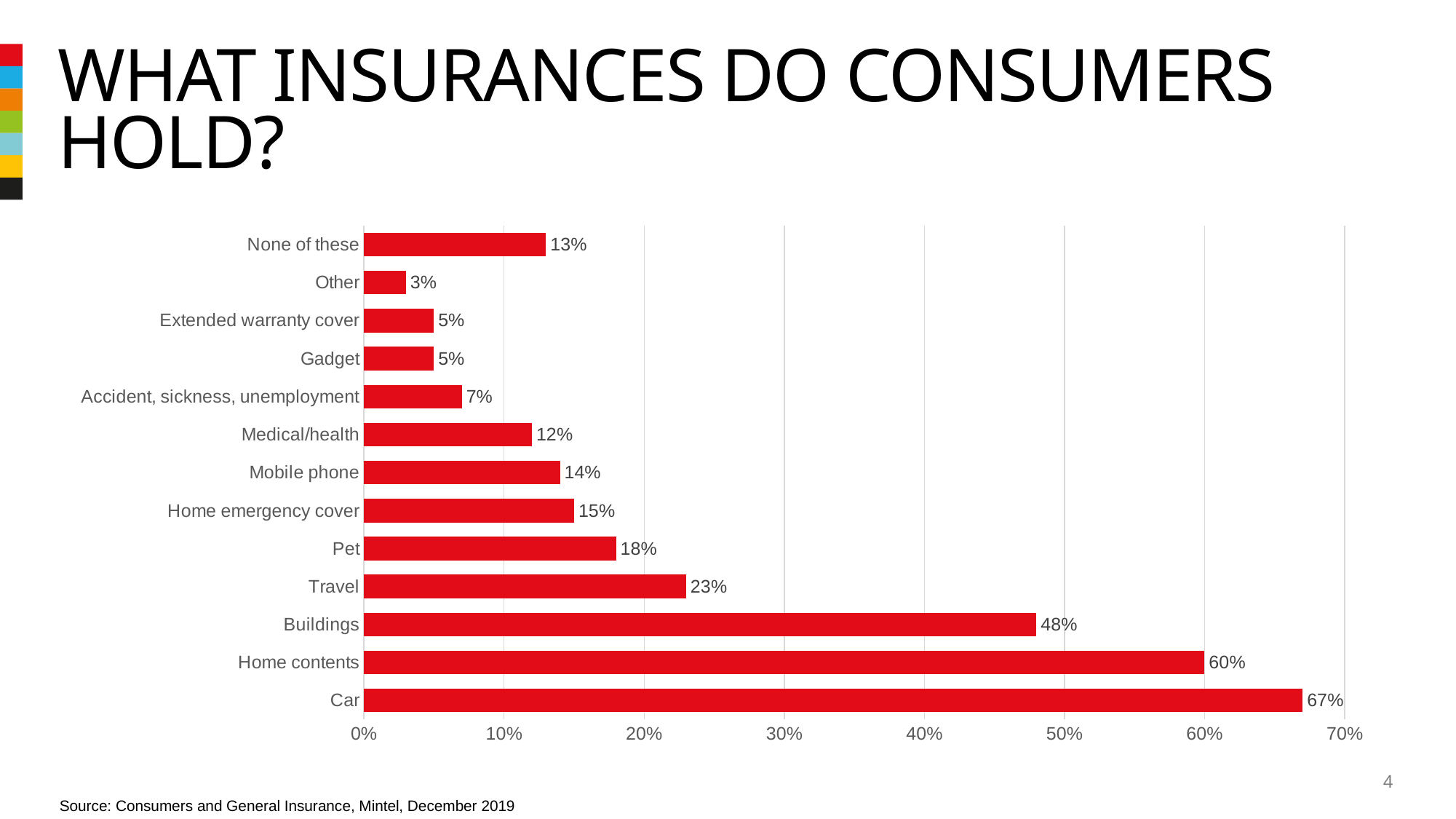
Is the value for Buildings greater or less than 50%? less What is the source cited for the chart data? Consumers and General Insurance, Mintel, December 2019 Which category has the lowest value on the chart? Other What is the difference between the values for Home contents and Buildings? 12% How many categories are shown on the chart? 13 What is the value for Home emergency cover? 15% What percentage of consumers hold car insurance? 67% Which is larger, the value for Travel or the value for Pet? Travel What kind of chart is shown on the slide? Bar chart What percentage of consumers selected 'None of these'? 13% Which insurance type has the highest share of consumers holding it? Car What is the difference between the values for Car and Home contents? 7%